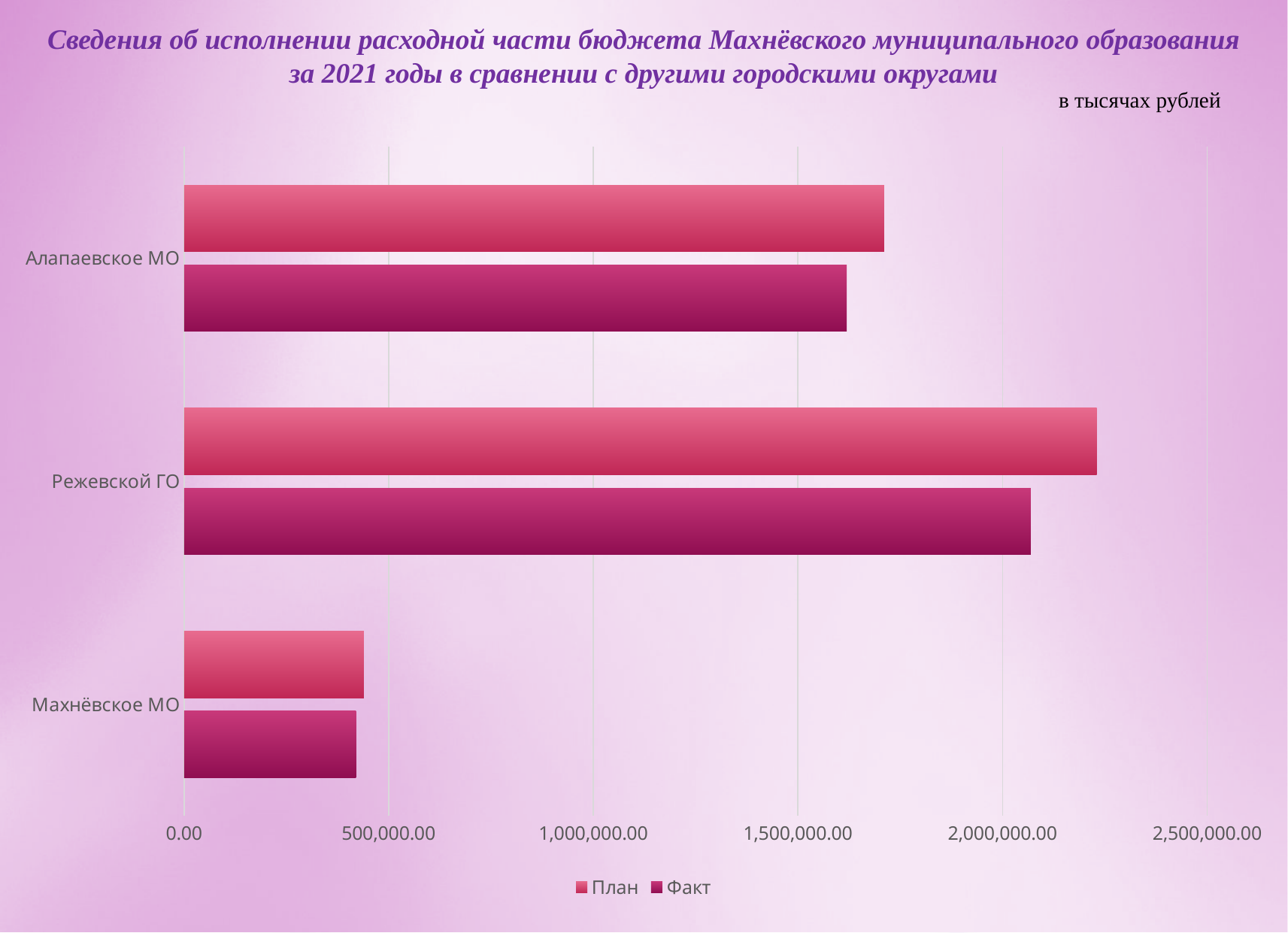
What are the names of the two series in the legend? План and Факт Is the План value for Режевской ГО greater or less than 2,000,000.00? greater How many categories (municipalities) are shown on the chart? 3 What kind of chart is shown on the slide? bar chart Which category has the larger Факт value: Алапаевское МО or Режевской ГО? Режевской ГО Which is larger for Режевской ГО: План or Факт? План Which category has the highest План value? Режевской ГО Is the Факт value for Махнёвское МО greater or less than 500,000.00? less In what units are the values on the chart expressed, according to the slide? в тысячах рублей How many series does the legend list? 2 Which category has the lowest Факт value? Махнёвское МО Is the План value for Алапаевское МО greater or less than 1,500,000.00? greater